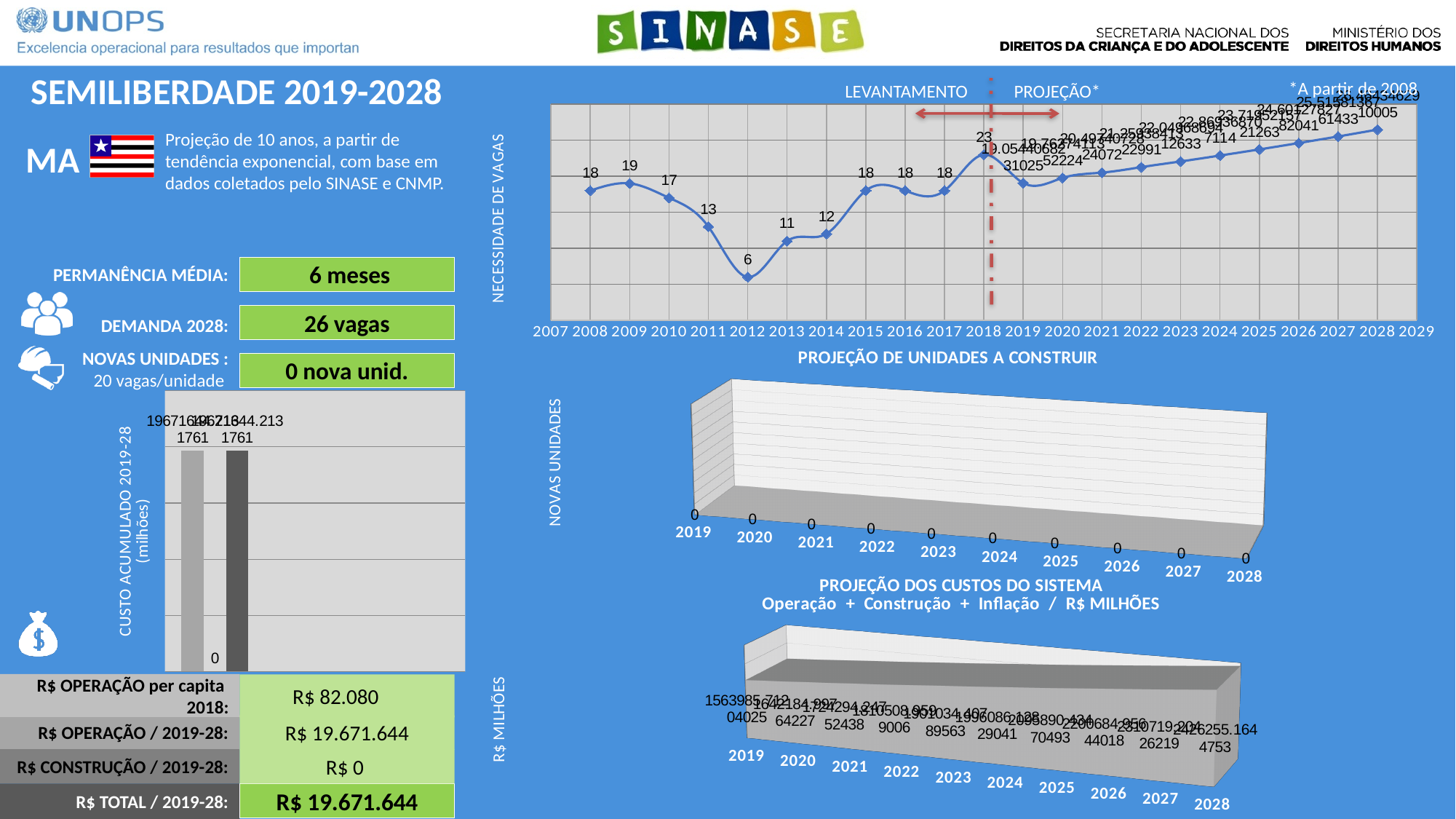
In the NECESSIDADE DE VAGAS line chart, what is the value for 2009? 19 What kind of chart is the NECESSIDADE DE VAGAS chart at the top right? line chart In the NECESSIDADE DE VAGAS line chart, which is larger, the value for 2011 or the value for 2013? 2011 In the NECESSIDADE DE VAGAS line chart, do the values rise or fall from 2018 to 2028? rise In the NECESSIDADE DE VAGAS line chart, what is the difference between the values for 2018 and 2012? 17 What kind of chart is the PROJEÇÃO DE UNIDADES A CONSTRUIR chart? 3D area chart In the NECESSIDADE DE VAGAS line chart, what is the value for 2012? 6 In the NECESSIDADE DE VAGAS line chart, what is the value for 2018? 23 In the PROJEÇÃO DE UNIDADES A CONSTRUIR chart, what is the value for 2019? 0 In the NECESSIDADE DE VAGAS line chart, which year has the lowest value? 2012 In the NECESSIDADE DE VAGAS chart, what are the two labels shown on either side of the vertical dashed line? LEVANTAMENTO and PROJEÇÃO How many years are shown on the x axis of the PROJEÇÃO DE UNIDADES A CONSTRUIR chart? 10